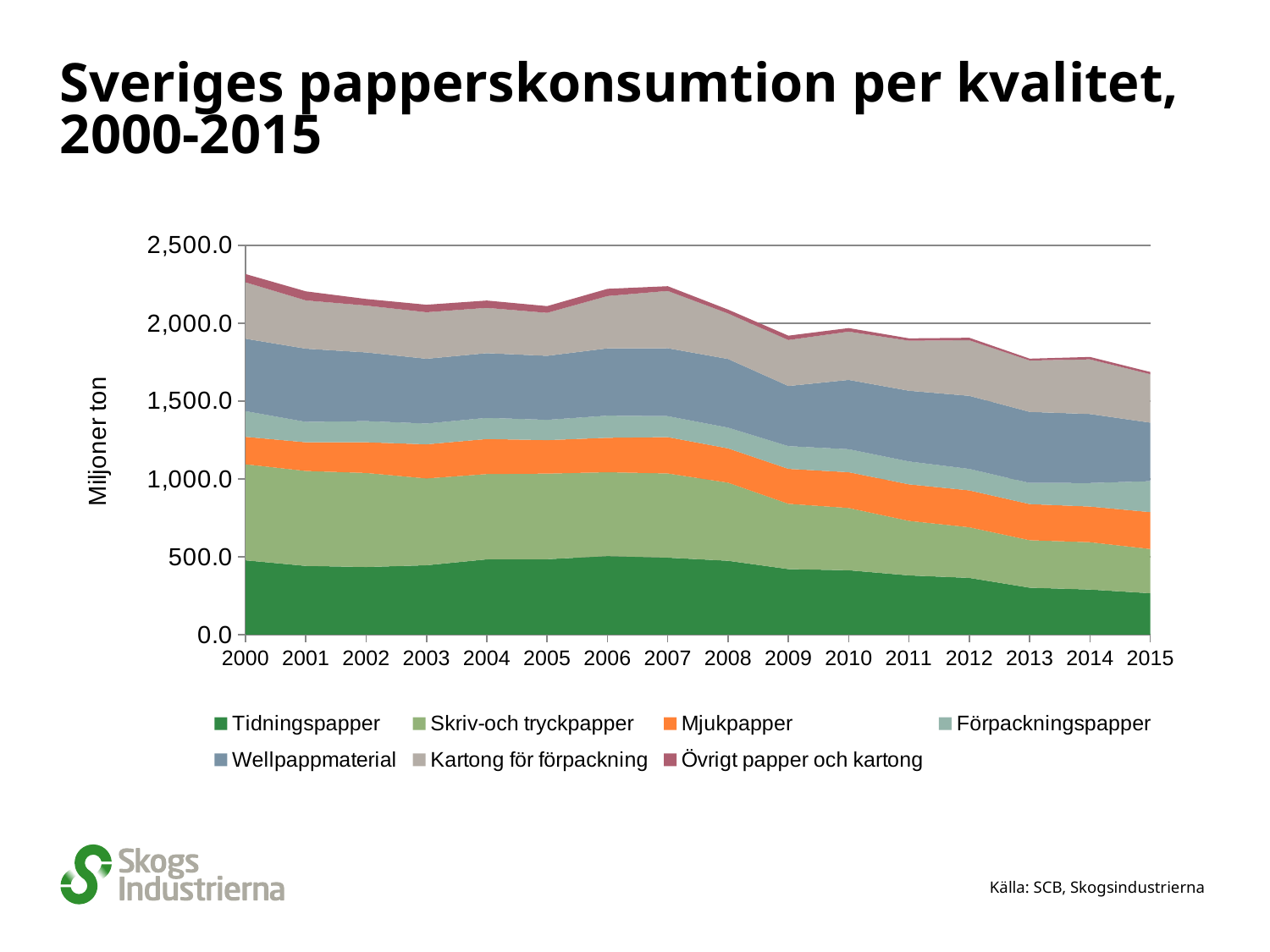
Is the value for Tidningspapper in 2015 greater or less than 500.0? less Which year has the larger total paper consumption, 2000 or 2015? 2000 How many years are plotted along the x axis of the chart? 16 Is the total paper consumption in 2007 greater or less than 2,000.0? greater Is the total paper consumption in 2015 greater or less than 2,000.0 million tonnes? less What kind of chart is shown on the slide? Stacked area chart Which year has the highest total paper consumption? 2000 Which year has the lowest total paper consumption? 2015 How many series does the chart's legend list? 7 Does the total paper consumption rise or fall from 2000 to 2015? Fall What is the label on the y axis of the chart? Miljoner ton